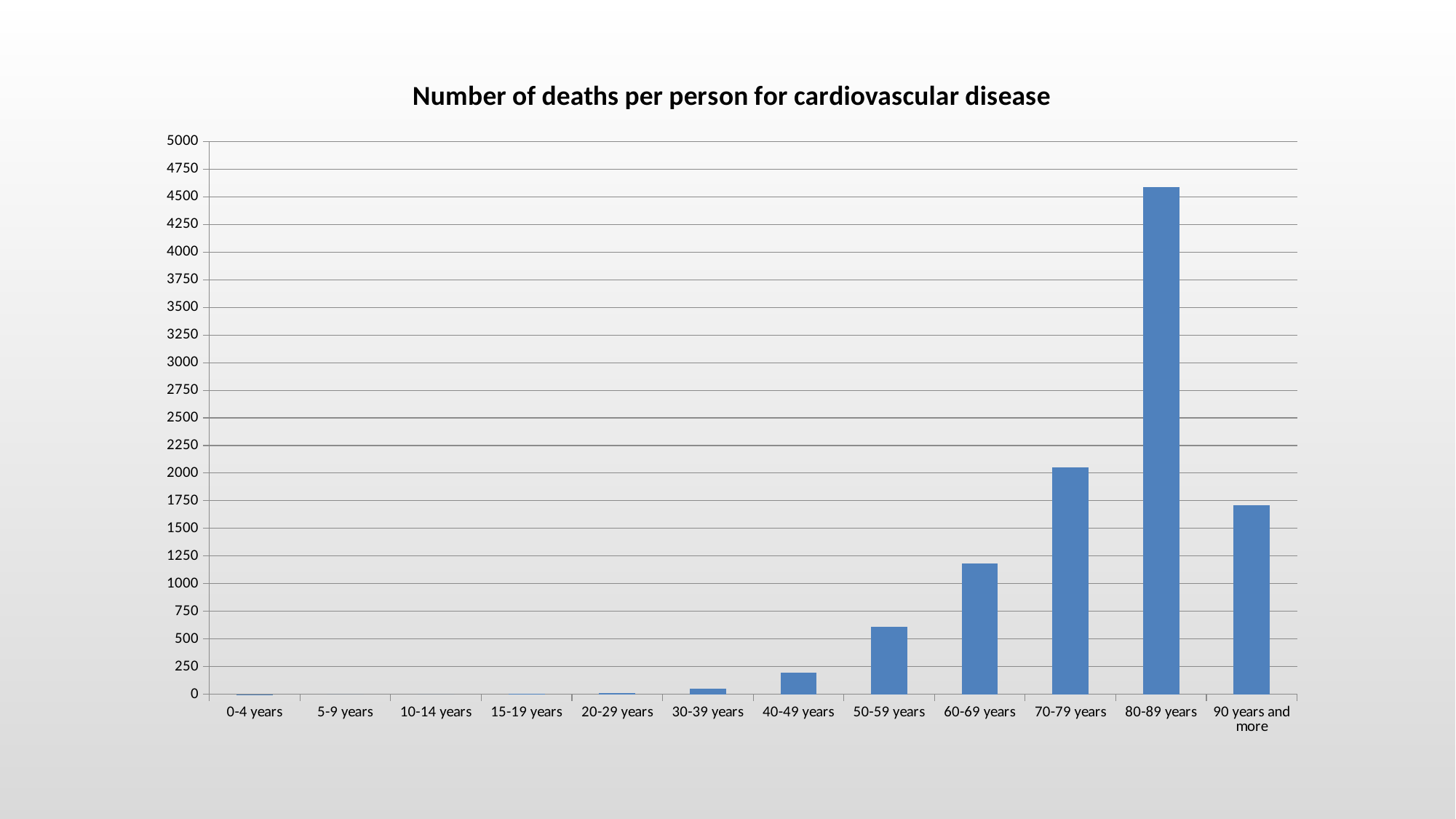
Is the value for 90 years and more greater or less than 1500? greater How many age categories are shown on the x axis? 12 Is the value for 80-89 years greater or less than 4000? greater Which age category has the highest value? 80-89 years What is the title of the chart? Number of deaths per person for cardiovascular disease Is the value for 60-69 years greater or less than 1000? greater What kind of chart is shown on the slide? bar chart Do the values rise or fall along the x axis from 0-4 years to 80-89 years? rise Which is larger, the value for 70-79 years or the value for 90 years and more? 70-79 years